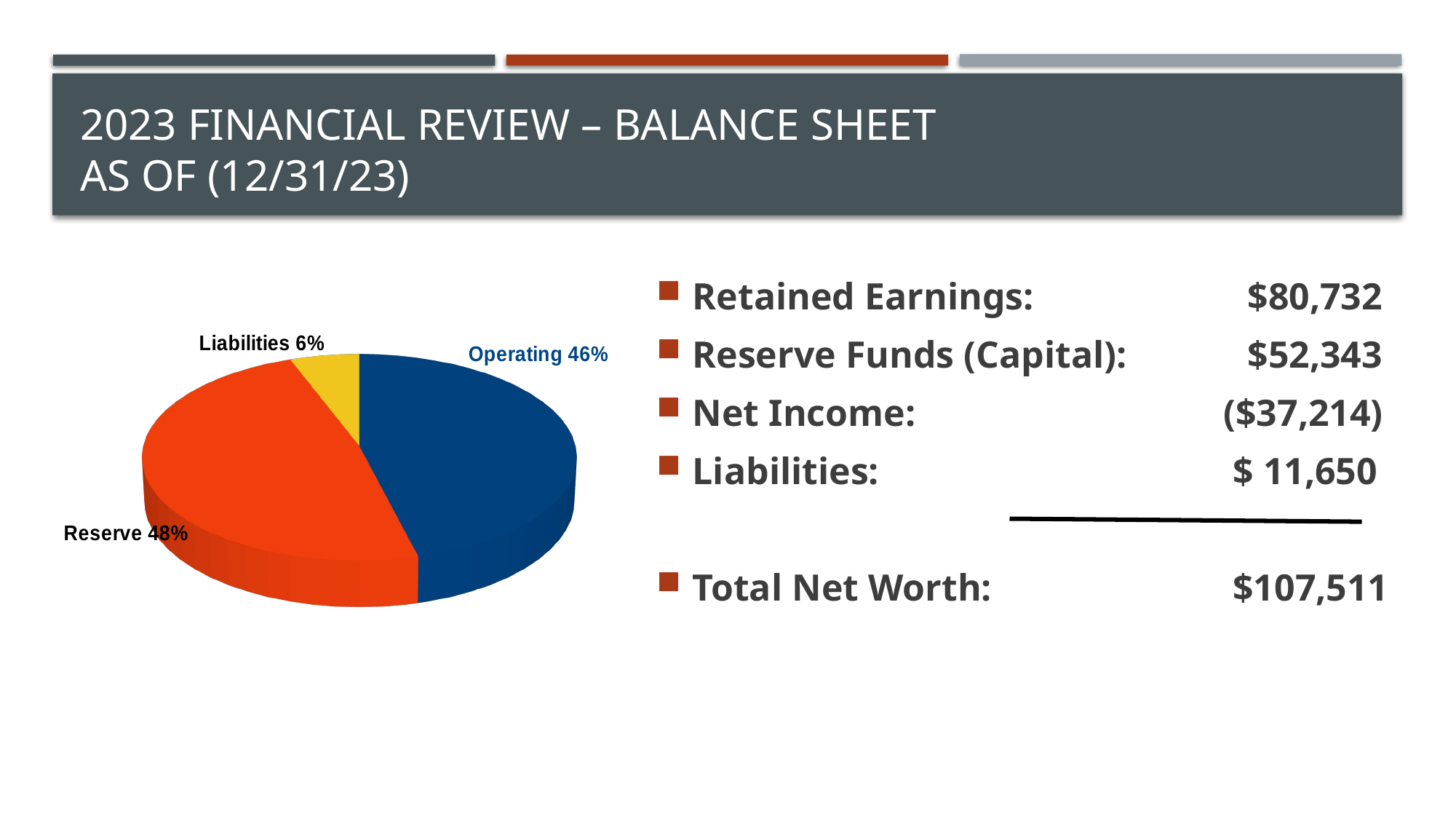
What share of the pie does Liabilities represent? 6% What is the difference in percentage points between the Reserve and Operating slices? 2 What share of the pie does Operating represent? 46% What kind of chart is shown on the slide? pie chart What is the difference in percentage points between the Operating and Liabilities slices? 40 How many slices does the pie chart have? 3 What share of the pie does Reserve represent? 48% Which slice of the pie is the largest? Reserve Which is larger, the Reserve slice or the Liabilities slice? Reserve Which slice of the pie is the smallest? Liabilities What colour is the Operating slice of the pie? blue What colour is the Liabilities slice of the pie? yellow